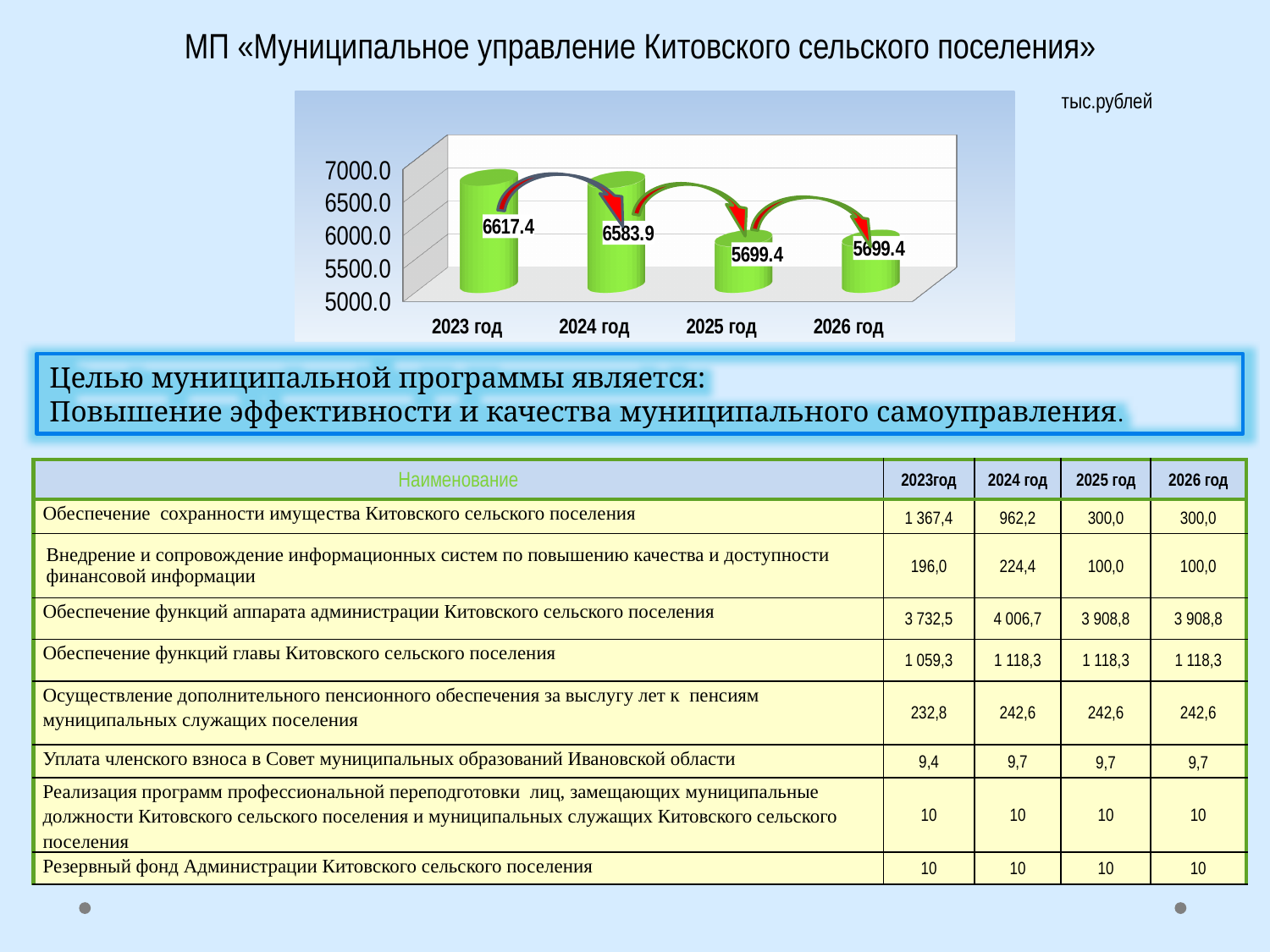
What is the value for 2024 год in the chart? 6583.9 What kind of chart is shown on the slide? bar chart Is the value for 2025 год greater or less than 6000.0? less What is the value for 2023 год in the chart? 6617.4 What is the difference between the values for 2024 год and 2025 год? 884.5 Do the values in the chart rise or fall from 2023 год to 2025 год? fall How many years are shown on the x axis of the chart? 4 What is the value for 2026 год in the chart? 5699.4 Which year has the highest value in the chart? 2023 год What is the value for 2025 год in the chart? 5699.4 Which is larger, the value for 2024 год or the value for 2025 год? 2024 год What is the difference between the values for 2023 год and 2024 год? 33.5